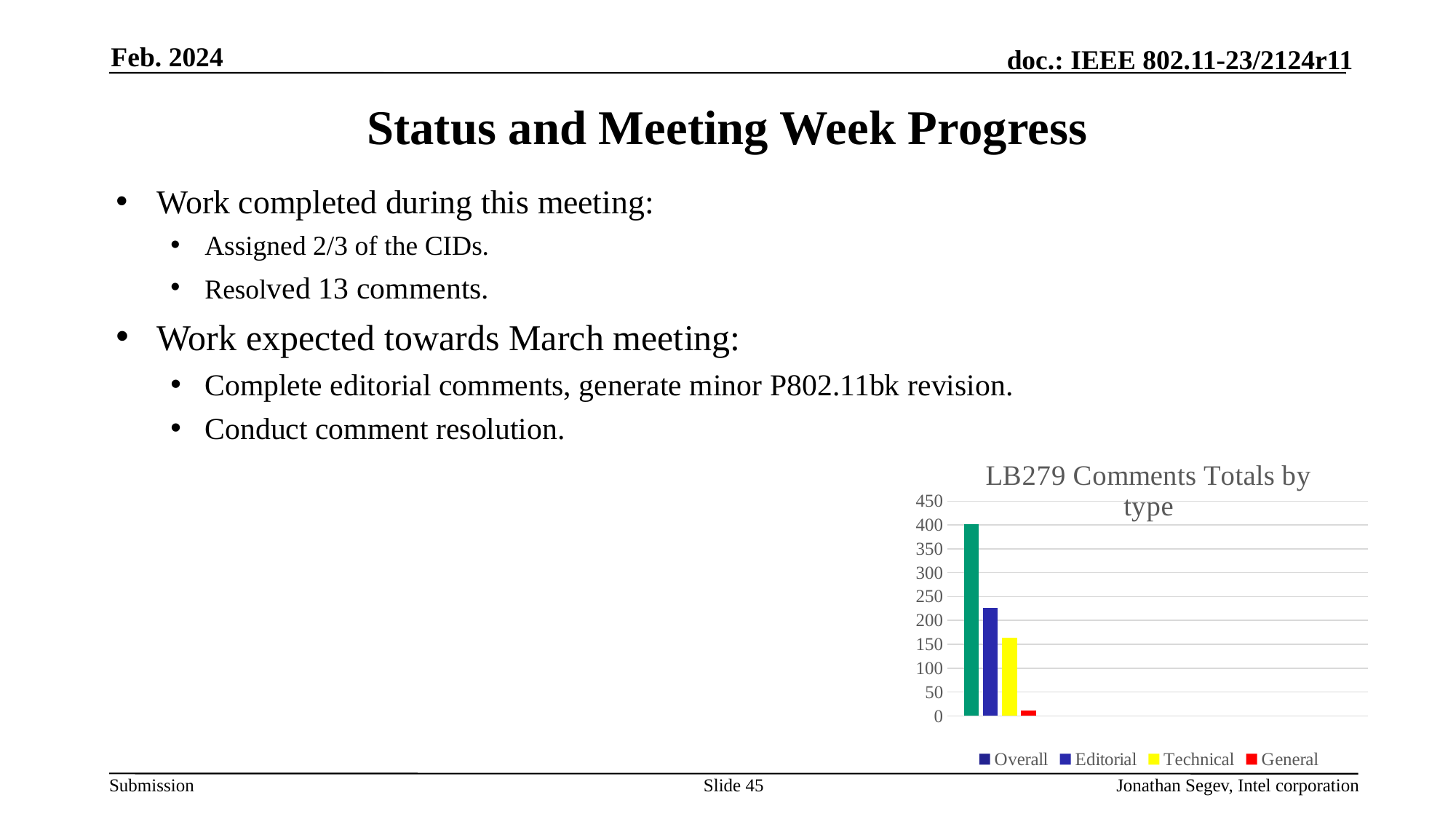
What kind of chart is shown on the slide? bar chart Is the value for General greater or less than 50? less What is the title of the chart on the slide? LB279 Comments Totals by type How many series does the chart legend list? 4 Which series has the highest value in the chart? Overall Is the value for Editorial greater or less than 200? greater Which series has the lowest value in the chart? General Is the value for Editorial greater or less than 250? less Which is larger, the value for Overall or the value for General? Overall Which is larger, the value for Editorial or the value for Technical? Editorial